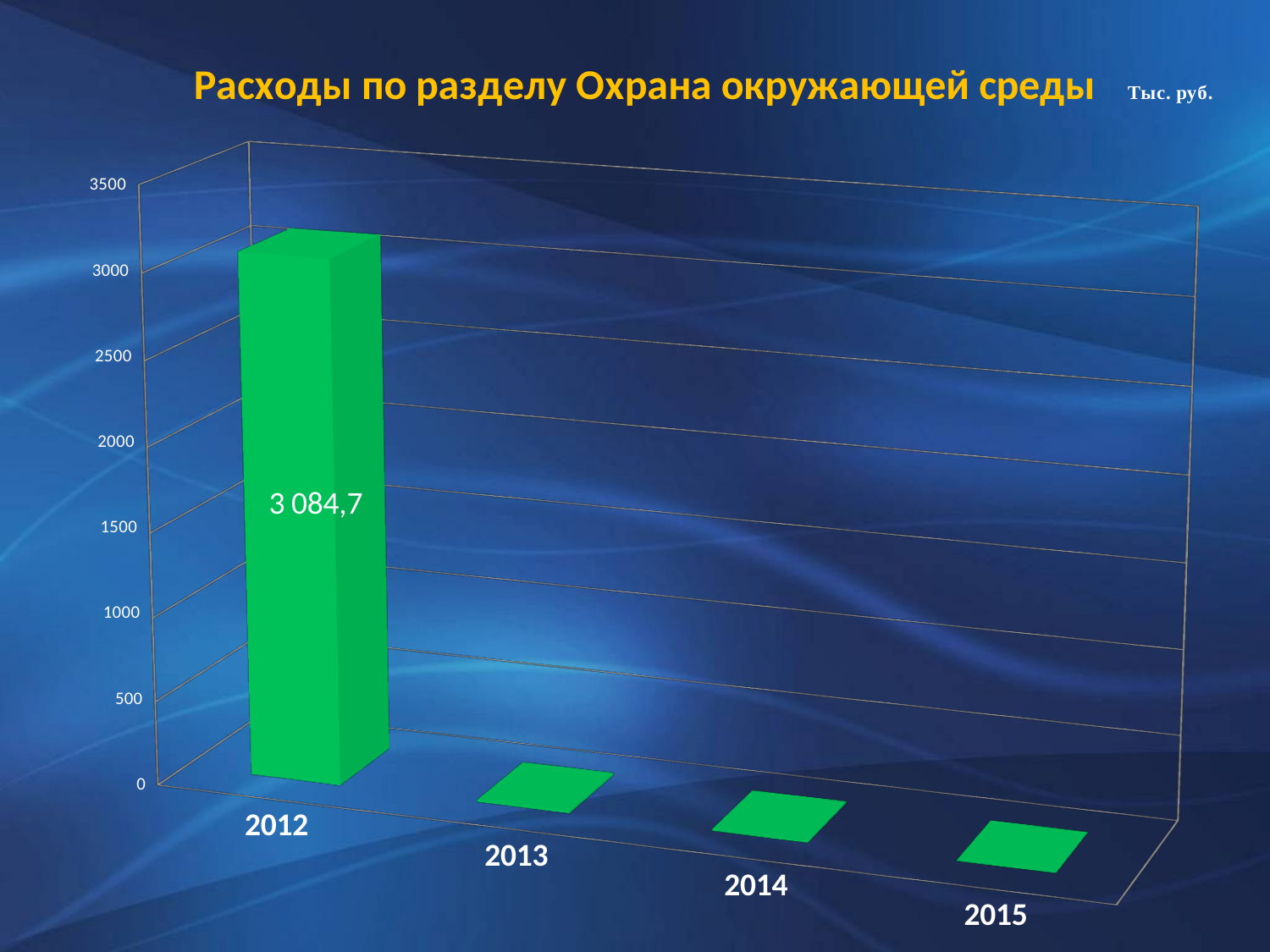
What is the title of the chart? Расходы по разделу Охрана окружающей среды How many years are shown on the x axis? 4 Is the value for 2012 greater or less than 3000? greater Which year has the highest value? 2012 Which is larger, the value for 2012 or the value for 2014? 2012 What kind of chart is shown on the slide? bar chart Is the value for 2015 greater or less than 500? less In what units are the values given, according to the slide? Тыс. руб. Do the values rise or fall from 2012 to 2015? fall Is the value for 2013 greater or less than 500? less What is the value for 2012? 3 084,7